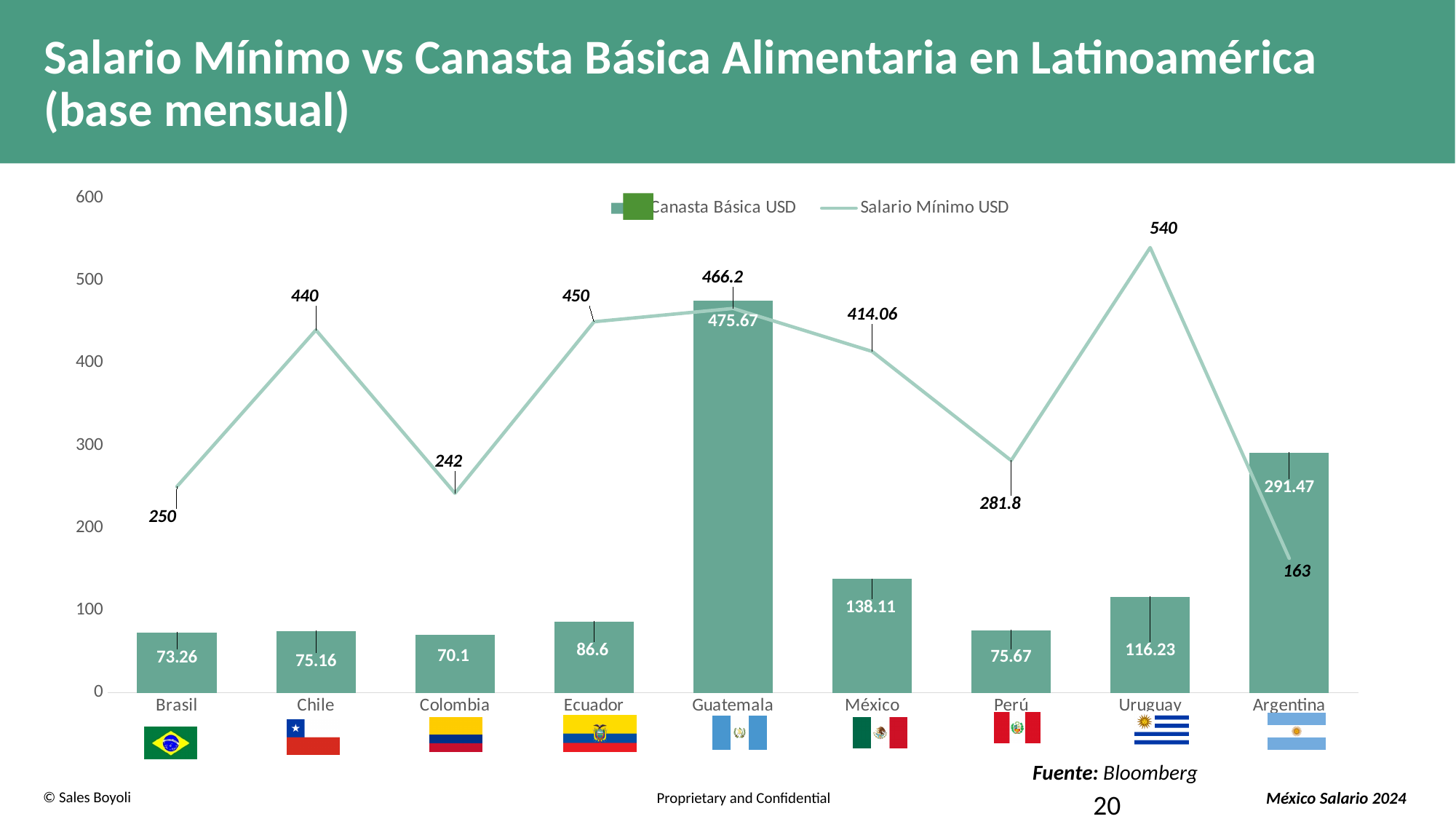
What is the Salario Mínimo USD value for Uruguay? 540 What is the Canasta Básica USD value for México? 138.11 What kind of chart is used for the Canasta Básica USD series? Bar chart How many countries are shown on the x axis? 9 Which is larger for Argentina: the Canasta Básica USD or the Salario Mínimo USD? Canasta Básica USD What is the difference between the Salario Mínimo USD values for Chile and Colombia? 198 Which country has the lowest Salario Mínimo USD value? Argentina How many series does the legend list? 2 What is the Canasta Básica USD value for Argentina? 291.47 What is the source cited for the chart data? Bloomberg Which country has the highest Canasta Básica USD value? Guatemala Which country has the lowest Canasta Básica USD value? Colombia